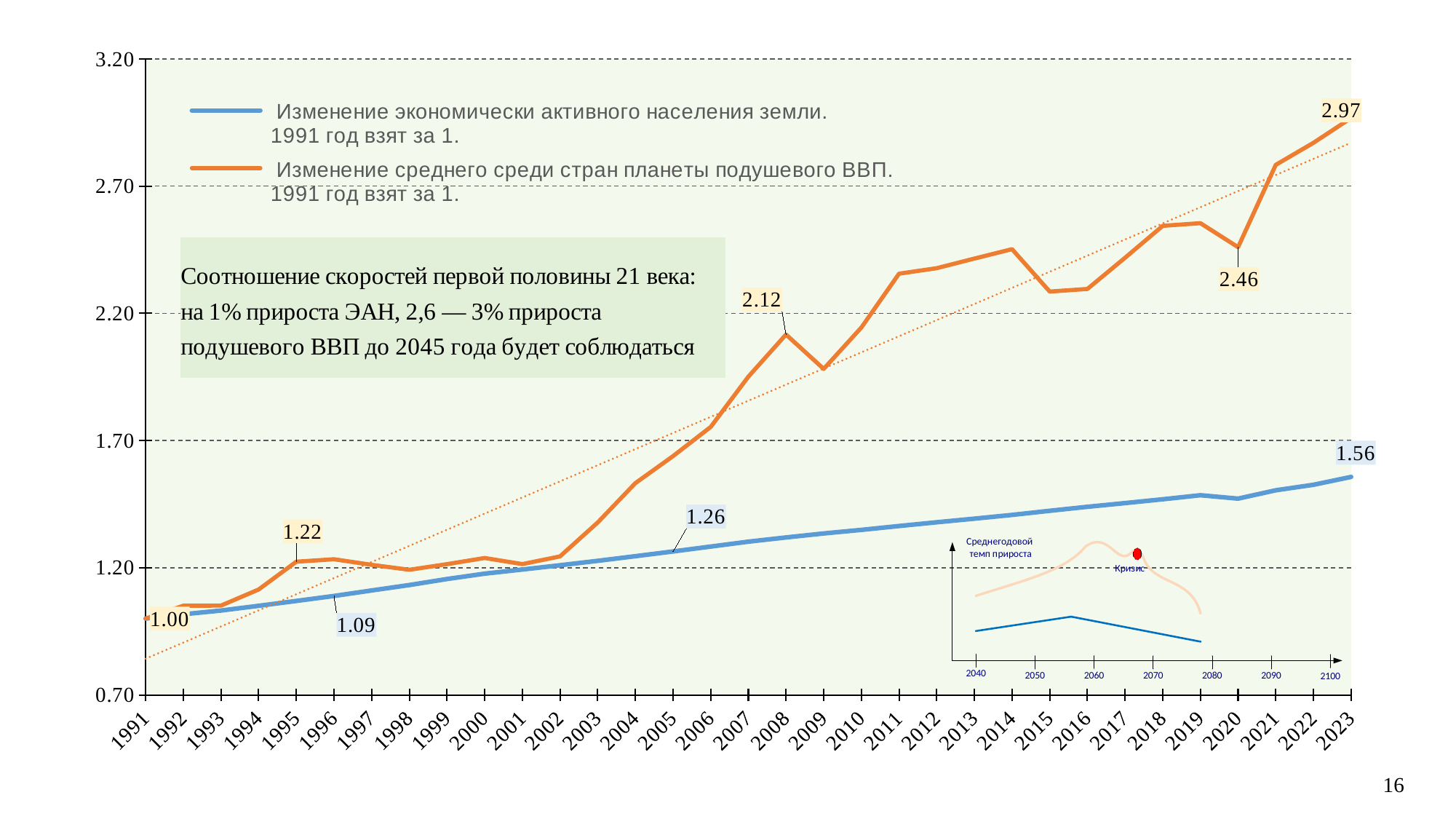
How many series does the legend list? 2 What is the value of the per-capita GDP series in 1995? 1.22 In 2023, which series has the higher value: economically active population or per-capita GDP? per-capita GDP What is the value of the per-capita GDP series in 2020? 2.46 What kind of chart is shown on the slide? line chart What is the value of the per-capita GDP series (orange line) in 2023? 2.97 Does the economically active population series rise or fall from 1991 to 2023? rise Is the value of the economically active population series in 2013 greater or less than 1.70? less What is the difference between the per-capita GDP value and the economically active population value in 2023? 1.41 Is the value of the per-capita GDP series in 2014 greater or less than 2.20? greater What is the value of the per-capita GDP series in 2008? 2.12 What is the value of the economically active population series (blue line) in 2023? 1.56